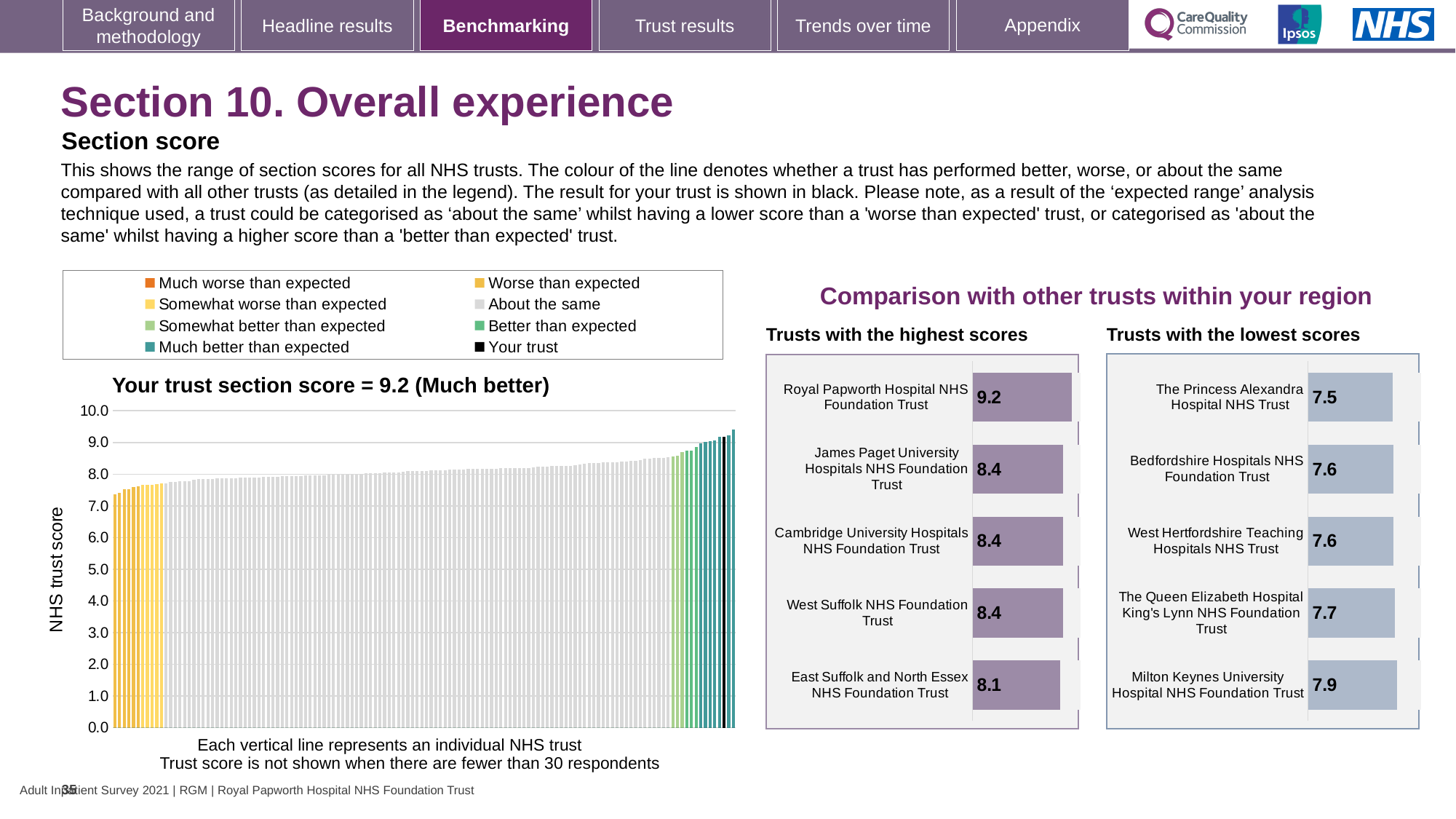
In the 'Trusts with the highest scores' chart, which trust has the lowest score? East Suffolk and North Essex NHS Foundation Trust In the 'Your trust section score' chart, do the bar values rise or fall from left to right along the x axis? rise In the 'Trusts with the lowest scores' chart, what is the score for The Princess Alexandra Hospital NHS Trust? 7.5 In the 'Your trust section score' chart, what is the section score for your trust? 9.2 What kind of chart is the 'Your trust section score' chart? bar chart In the 'Trusts with the lowest scores' chart, which trust has the highest score? Milton Keynes University Hospital NHS Foundation Trust In the 'Trusts with the lowest scores' chart, which has the larger score: Milton Keynes University Hospital NHS Foundation Trust or The Queen Elizabeth Hospital King's Lynn NHS Foundation Trust? Milton Keynes University Hospital NHS Foundation Trust In the 'Trusts with the lowest scores' chart, what is the difference between the scores of Milton Keynes University Hospital NHS Foundation Trust and The Princess Alexandra Hospital NHS Trust? 0.4 In the 'Trusts with the highest scores' chart, what is the difference between the scores of Royal Papworth Hospital NHS Foundation Trust and East Suffolk and North Essex NHS Foundation Trust? 1.1 In the 'Trusts with the highest scores' chart, what is the score for Royal Papworth Hospital NHS Foundation Trust? 9.2 In the 'Trusts with the highest scores' chart, how many trusts are shown? 5 In the 'Trusts with the highest scores' chart, what is the score for East Suffolk and North Essex NHS Foundation Trust? 8.1